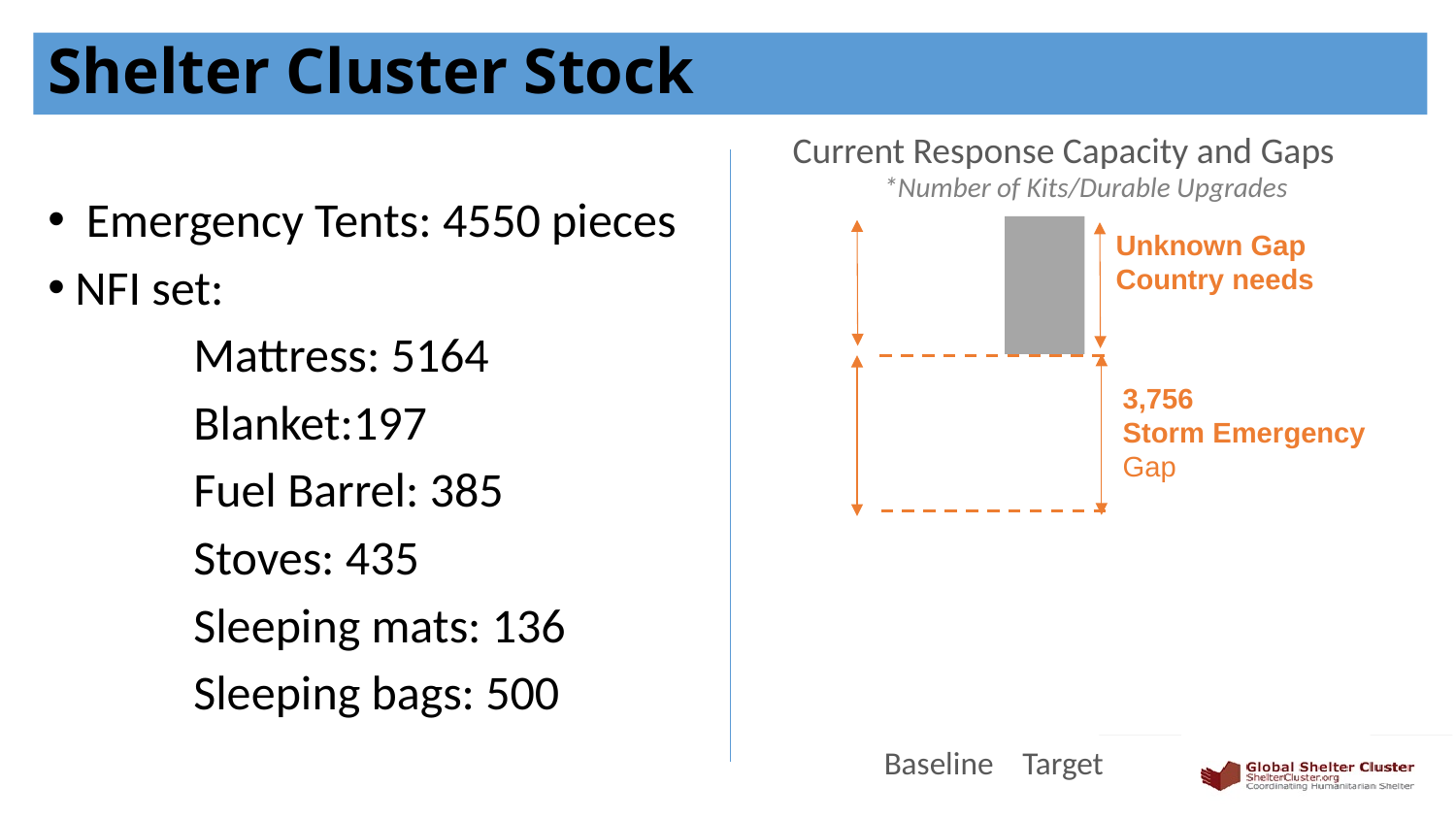
In the chart 'Current Response Capacity and Gaps', is the Storm Emergency Gap value greater or less than 3,000? greater How many categories are labelled along the x axis of the chart 'Current Response Capacity and Gaps'? 2 What are the two x-axis category labels in the chart 'Current Response Capacity and Gaps'? Baseline and Target What is the title of the chart on the right side of the slide? Current Response Capacity and Gaps What kind of chart is 'Current Response Capacity and Gaps'? bar chart In the chart 'Current Response Capacity and Gaps', what value is given for the Storm Emergency Gap? 3,756 In the chart 'Current Response Capacity and Gaps', what is the gap above the Storm Emergency Gap labelled as? Unknown Gap Country needs